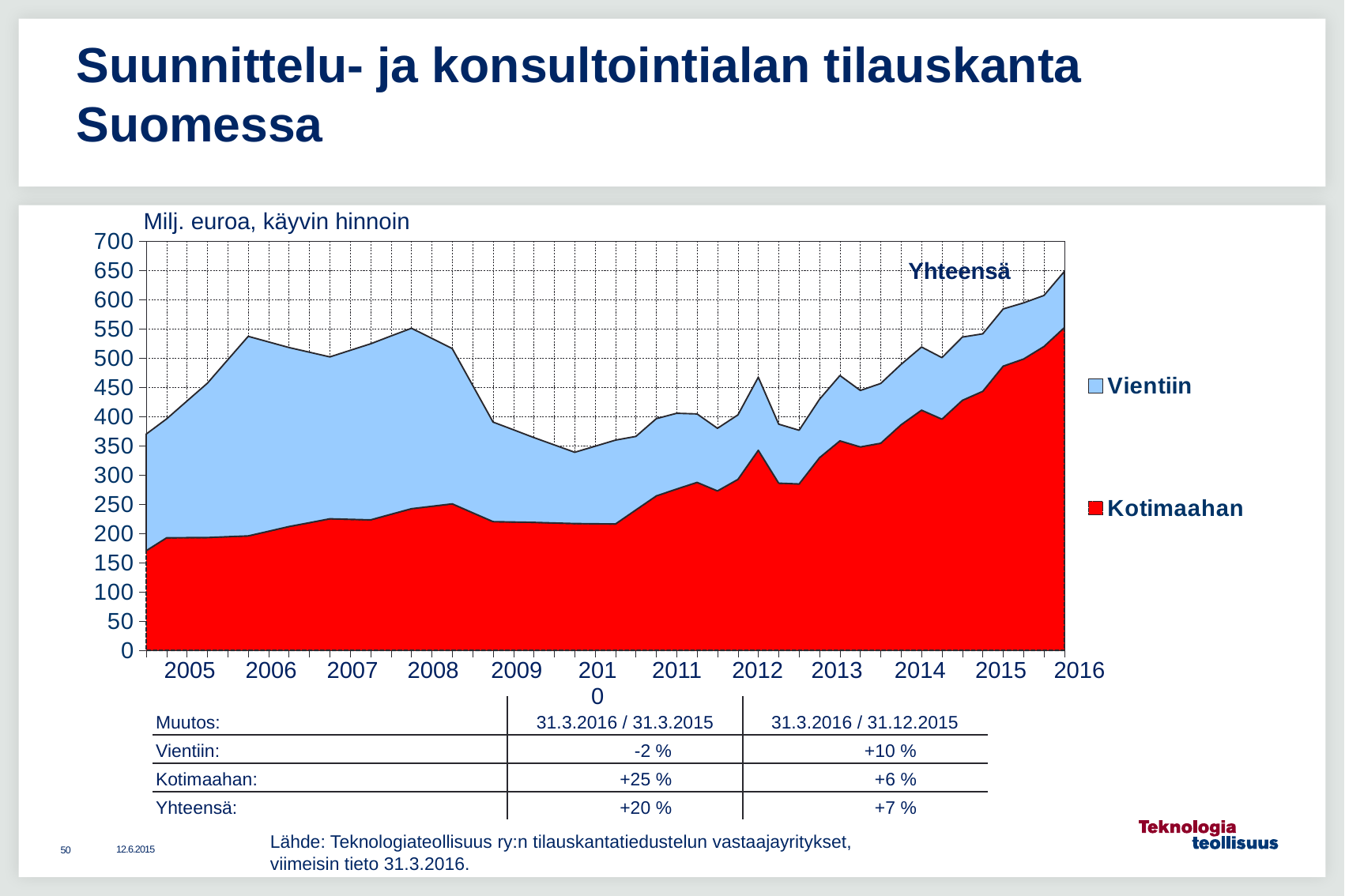
What unit label is shown above the chart's vertical axis? Milj. euroa, käyvin hinnoin What are the two series named in the chart legend? Vientiin and Kotimaahan What kind of chart is shown on the slide? area chart Is the Kotimaahan value at the end of the chart in 2016 greater or less than 500? greater In which year does the total (Yhteensä) reach its highest point on the chart? 2016 Is the total (Yhteensä) value at the end of the chart in 2016 greater or less than 600? greater Is the total (Yhteensä) value in 2009 greater or less than 450? less At the end of the chart in 2016, which is larger, the Kotimaahan portion or the Vientiin portion? Kotimaahan Does the Kotimaahan series rise or fall between 2012 and 2016? rise How many series does the chart legend list? 2 How many years are labelled on the x axis of the chart? 12